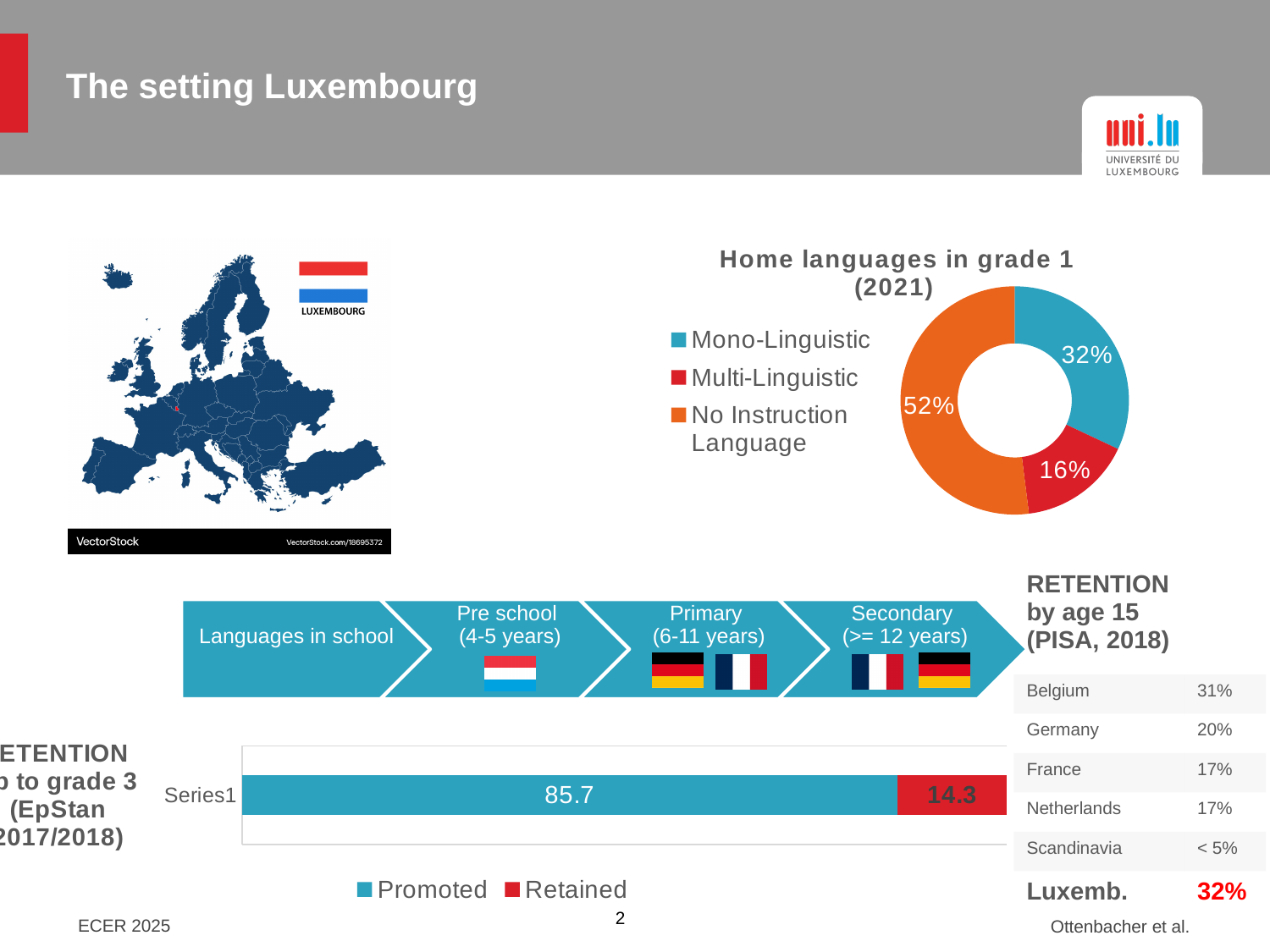
In the 'Home languages in grade 1 (2021)' chart, what share is Mono-Linguistic? 32% In the 'Home languages in grade 1 (2021)' chart, which category has the largest share? No Instruction Language In the bar chart at the bottom of the slide, how many series does the legend list? 2 What kind of chart is 'Home languages in grade 1 (2021)'? Donut (pie) chart In the bar chart at the bottom of the slide, what is the value for Retained? 14.3 In the 'Home languages in grade 1 (2021)' chart, which category has the smallest share? Multi-Linguistic In the 'Home languages in grade 1 (2021)' chart, what share is Multi-Linguistic? 16% In the 'Home languages in grade 1 (2021)' chart, what share is No Instruction Language? 52% In the 'Home languages in grade 1 (2021)' chart, how many percentage points larger is No Instruction Language than Mono-Linguistic? 20 In the bar chart at the bottom of the slide, what is the value for Promoted? 85.7 In the 'Home languages in grade 1 (2021)' chart, how many categories does the legend list? 3 In the bar chart at the bottom of the slide, which is larger, Promoted or Retained? Promoted